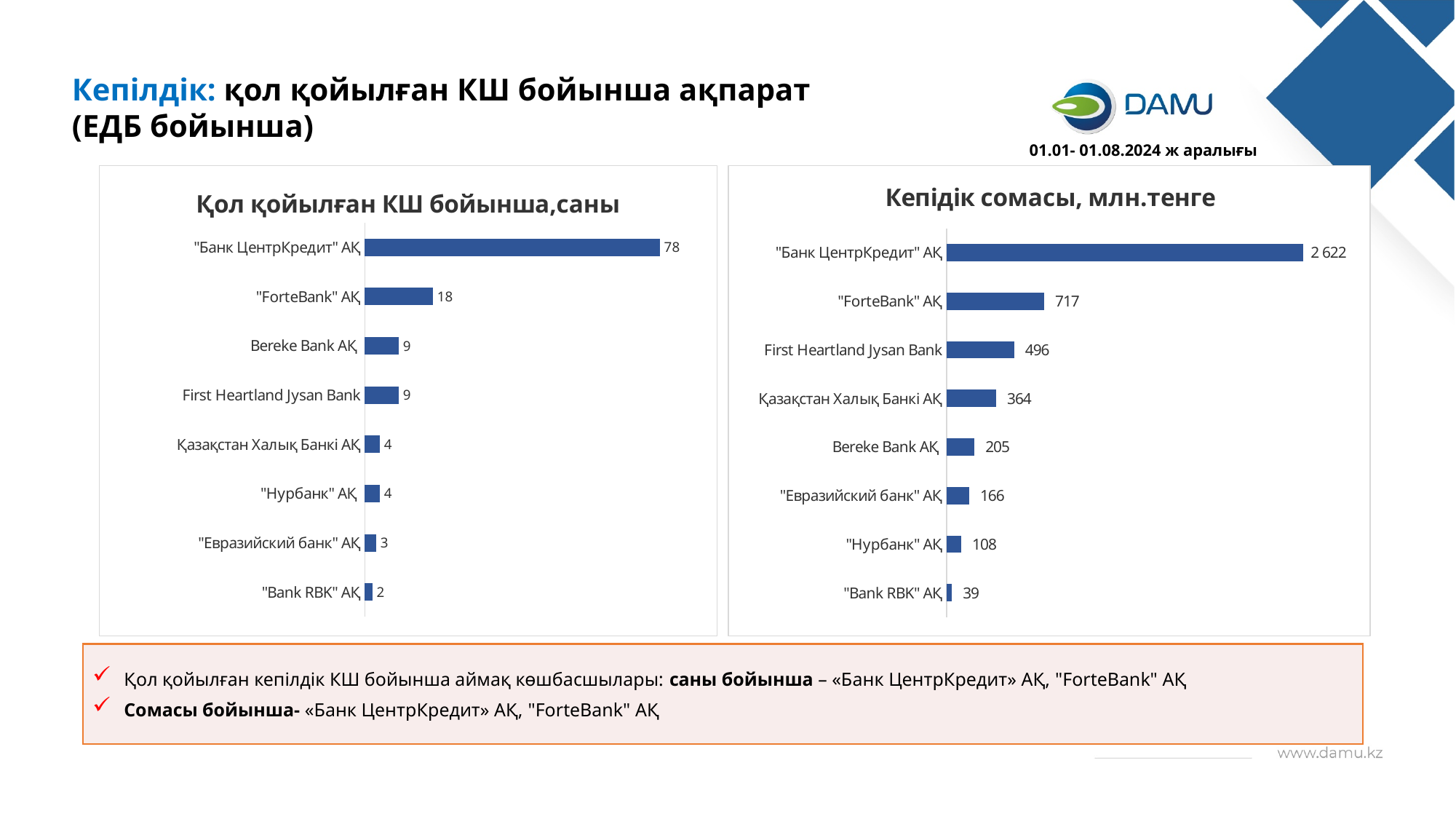
In the chart titled "Кепідік сомасы, млн.тенге", what is the difference between the values for "ForteBank" АҚ and First Heartland Jysan Bank? 221 In the chart titled "Кепідік сомасы, млн.тенге", which is larger: the value for Bereke Bank АҚ or the value for "Евразийский банк" АҚ? Bereke Bank АҚ In the chart titled "Қол қойылған КШ бойынша,саны", what is the value for "ForteBank" АҚ? 18 In the chart titled "Қол қойылған КШ бойынша,саны", what is the difference between the values for "Банк ЦентрКредит" АҚ and "ForteBank" АҚ? 60 How many categories are shown in the chart titled "Кепідік сомасы, млн.тенге"? 8 In the chart titled "Қол қойылған КШ бойынша,саны", which category has the highest value? "Банк ЦентрКредит" АҚ What is the title of the chart on the right side of the slide? Кепідік сомасы, млн.тенге In the chart titled "Кепідік сомасы, млн.тенге", what is the value for Қазақстан Халық Банкі АҚ? 364 In the chart titled "Кепідік сомасы, млн.тенге", which category has the lowest value? "Bank RBK" АҚ What kind of chart is the chart titled "Қол қойылған КШ бойынша,саны"? Bar chart In the chart titled "Қол қойылған КШ бойынша,саны", which is larger: the value for "Евразийский банк" АҚ or the value for "Bank RBK" АҚ? "Евразийский банк" АҚ In the chart titled "Кепідік сомасы, млн.тенге", what is the value for "Банк ЦентрКредит" АҚ? 2 622